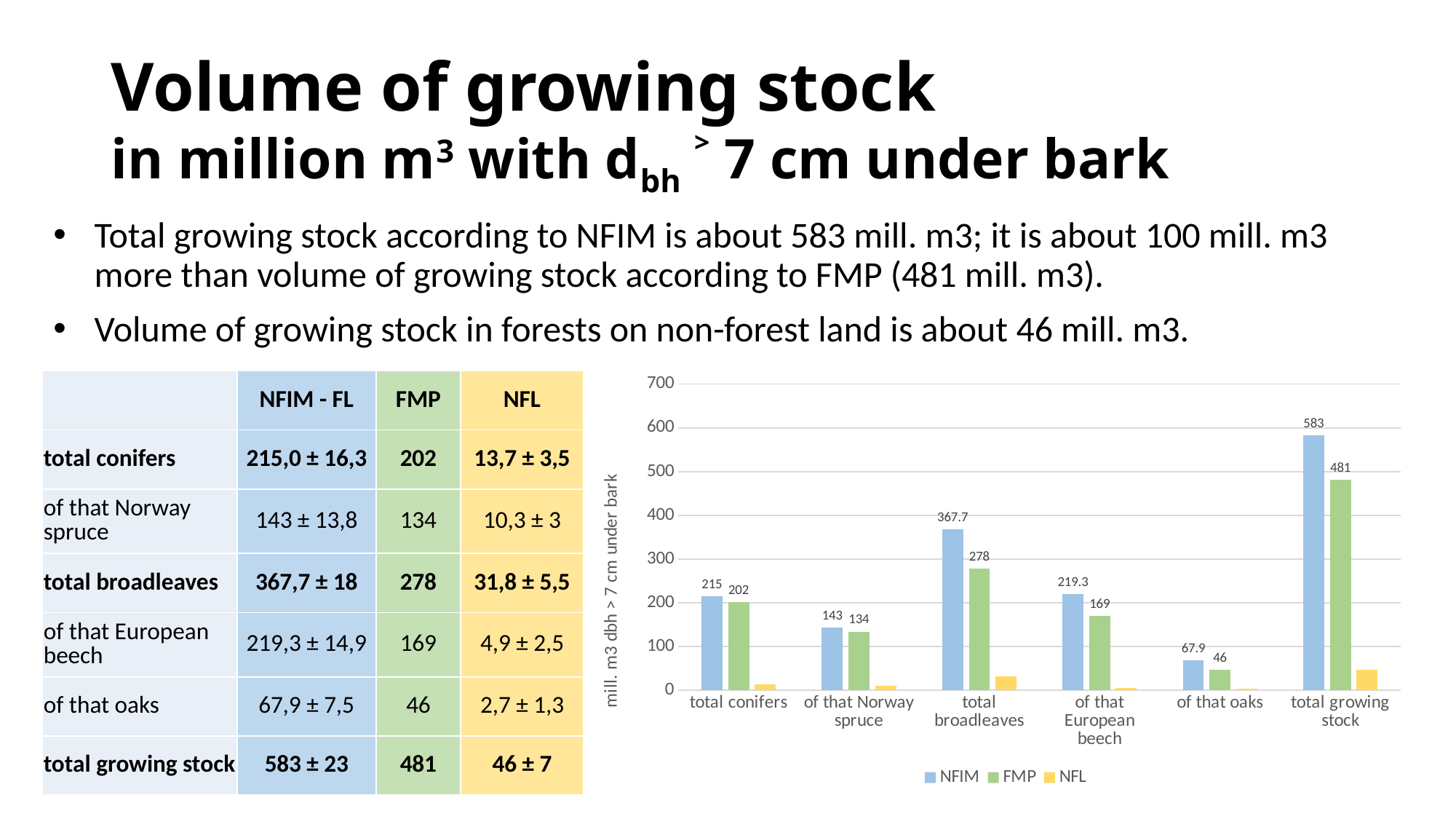
How many series does the chart legend list? 3 For of that European beech, which series has the larger value in the chart, NFIM or FMP? NFIM What is the FMP value for total growing stock in the chart? 481 Which category has the highest NFIM value in the chart? total growing stock What is the NFIM value for total broadleaves in the chart? 367.7 What kind of chart is shown on the slide? bar chart Which category has the lowest FMP value in the chart? of that oaks What is the difference between the NFIM and FMP values for total broadleaves in the chart? 89.7 What is the difference between the NFIM and FMP values for total growing stock in the chart? 102 What is the NFIM value for of that oaks in the chart? 67.9 Is the NFL value for total growing stock in the chart greater or less than 100? less How many categories are shown on the x axis of the chart? 6